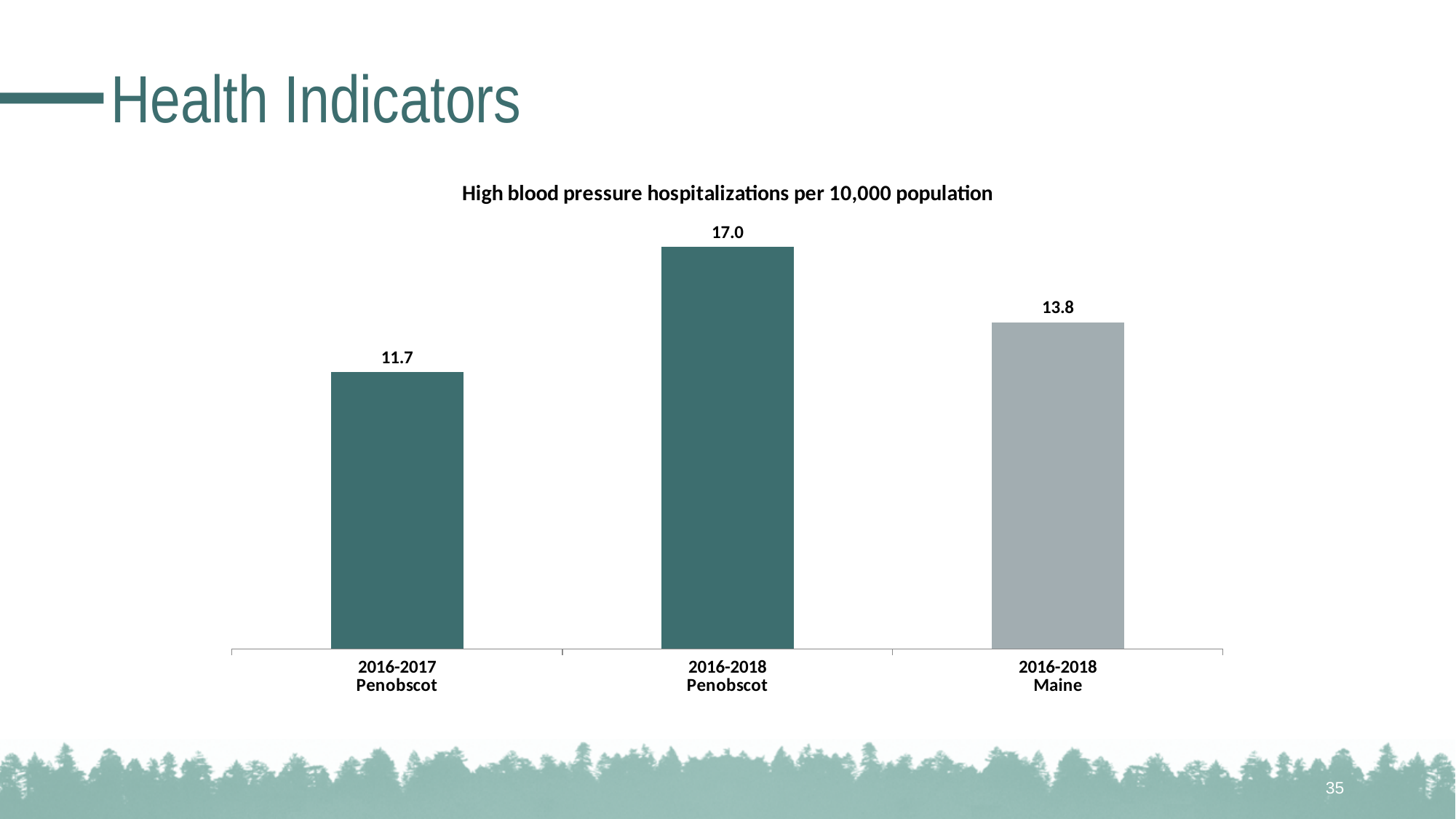
What is the title of the chart? High blood pressure hospitalizations per 10,000 population What is the value for 2016-2017 Penobscot? 11.7 What is the value for 2016-2018 Penobscot? 17.0 How many categories are shown in the chart? 3 What is the difference between the values for 2016-2018 Penobscot and 2016-2017 Penobscot? 5.3 Which bar is shown in a different (grey) colour from the others? 2016-2018 Maine Which is larger, the value for 2016-2018 Maine or the value for 2016-2017 Penobscot? 2016-2018 Maine What is the difference between the values for 2016-2018 Penobscot and 2016-2018 Maine? 3.2 What is the value for 2016-2018 Maine? 13.8 What kind of chart is shown on the slide? Bar chart Which category has the lowest value? 2016-2017 Penobscot Which category has the highest value? 2016-2018 Penobscot